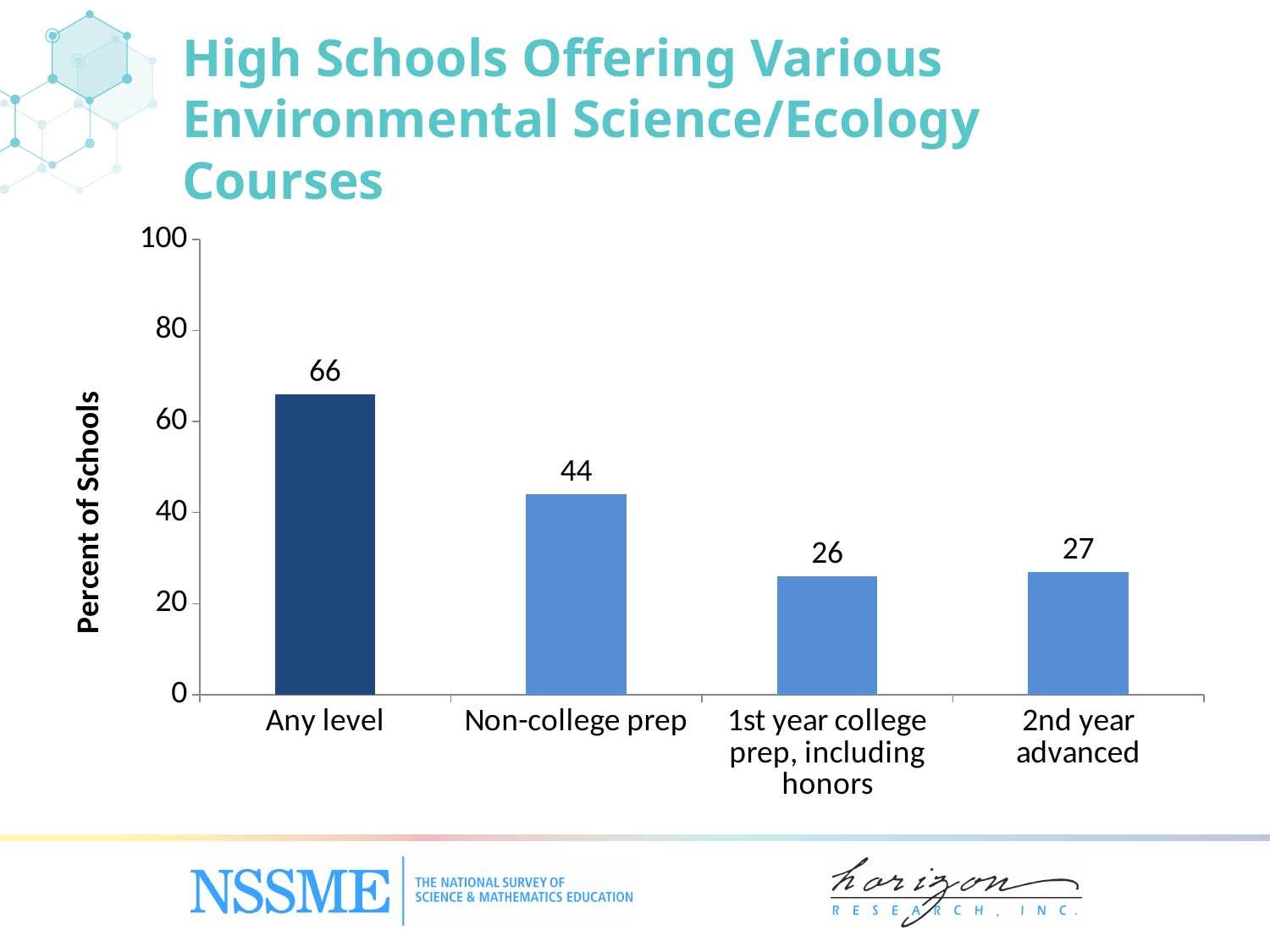
Which category has the lowest percent of schools? 1st year college prep, including honors What is the value for 2nd year advanced? 27 What is the difference between the values for Any level and Non-college prep? 22 How many categories are shown on the x axis? 4 Which is larger, the value for Non-college prep or the value for 2nd year advanced? Non-college prep Is the value for Any level greater or less than 60? greater What is the value for Non-college prep? 44 Which category has the highest percent of schools? Any level What percent of schools offer an environmental science/ecology course at any level? 66 What kind of chart is shown on the slide? Bar chart What is the label of the vertical axis? Percent of Schools What is the value for 1st year college prep, including honors? 26